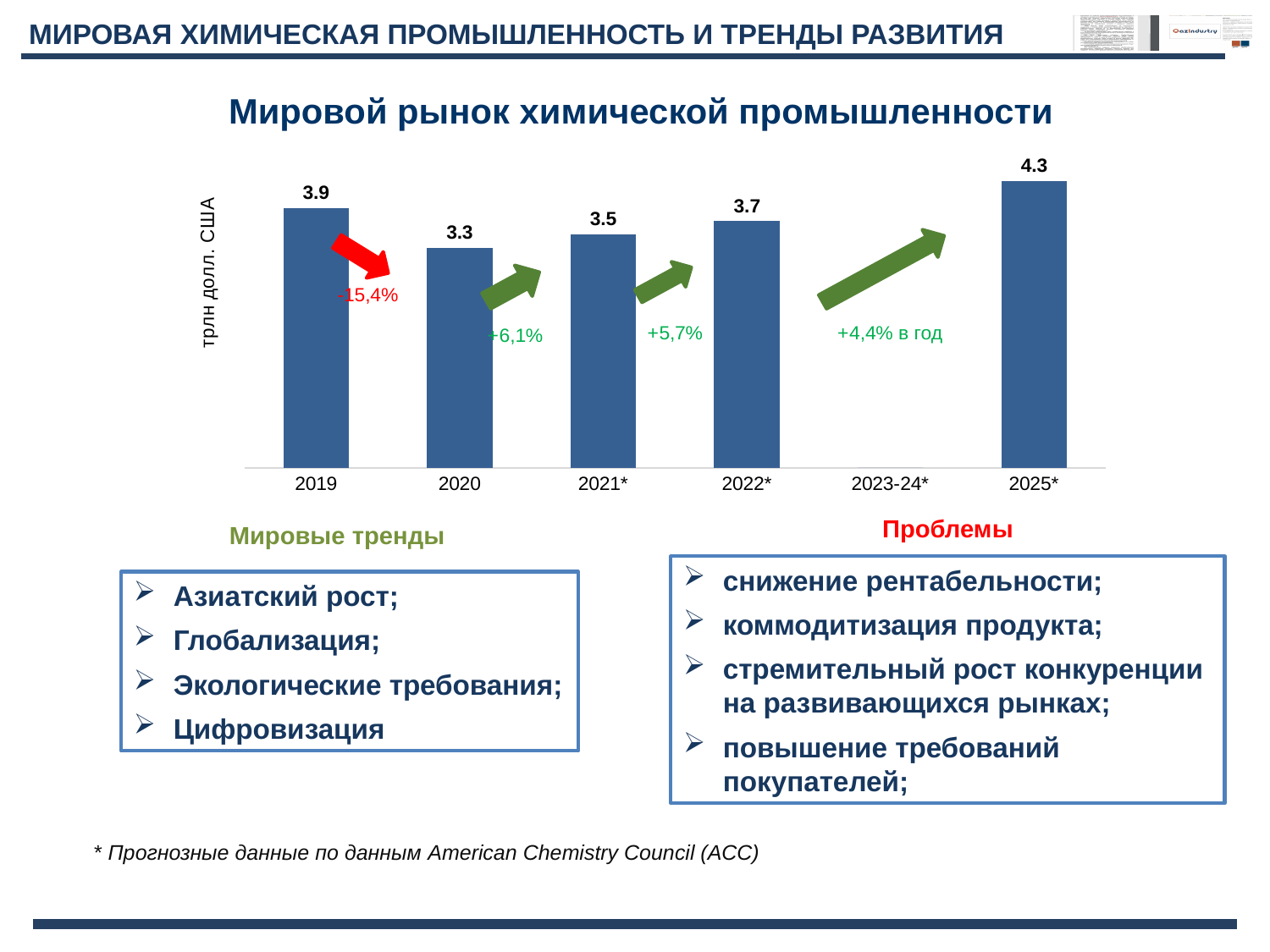
What is the value of the bar for 2022*? 3.7 What type of chart is shown on the slide? Bar chart What is the difference between the values for 2025* and 2019? 0.4 How many bars are plotted in the chart? 5 What is the value of the bar for 2020? 3.3 Which year has the highest bar? 2025* What is the value of the bar for 2019? 3.9 What is the difference between the values for 2019 and 2020? 0.6 Which is larger, the value for 2021* or the value for 2022*? 2022* What is the value of the bar for 2025*? 4.3 Which year has the lowest bar? 2020 What is the title of the chart? Мировой рынок химической промышленности